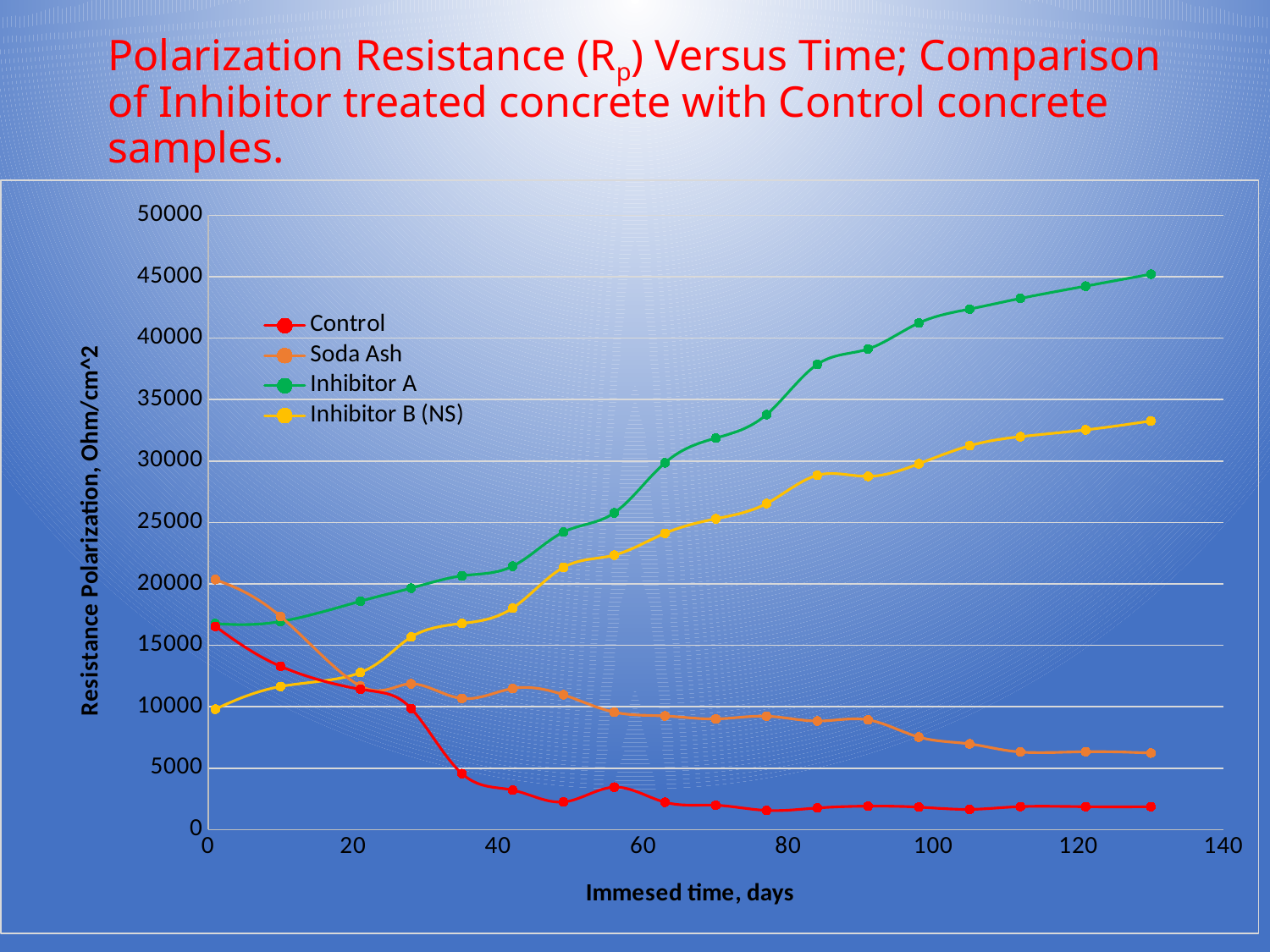
Which series has the lowest resistance polarization at the end of the immersion period (around 130 days)? Control What kind of chart is shown on the slide? line chart How many series does the legend list? 4 Which series are listed in the legend? Control, Soda Ash, Inhibitor A, Inhibitor B (NS) Does the Control series rise or fall as immersed time increases? fall Is the value for Inhibitor B (NS) at about 130 days greater or less than 30000? greater What is the label of the x axis? Immesed time, days Is the value for Control at about 130 days greater or less than 5000? less At the start of immersion (day 0), which is larger: the value for Soda Ash or the value for Inhibitor B (NS)? Soda Ash Is the value for Inhibitor A at about 100 days greater or less than 40000? greater Does the Inhibitor A series rise or fall as immersed time increases? rise Which series has the highest resistance polarization at the end of the immersion period (around 130 days)? Inhibitor A